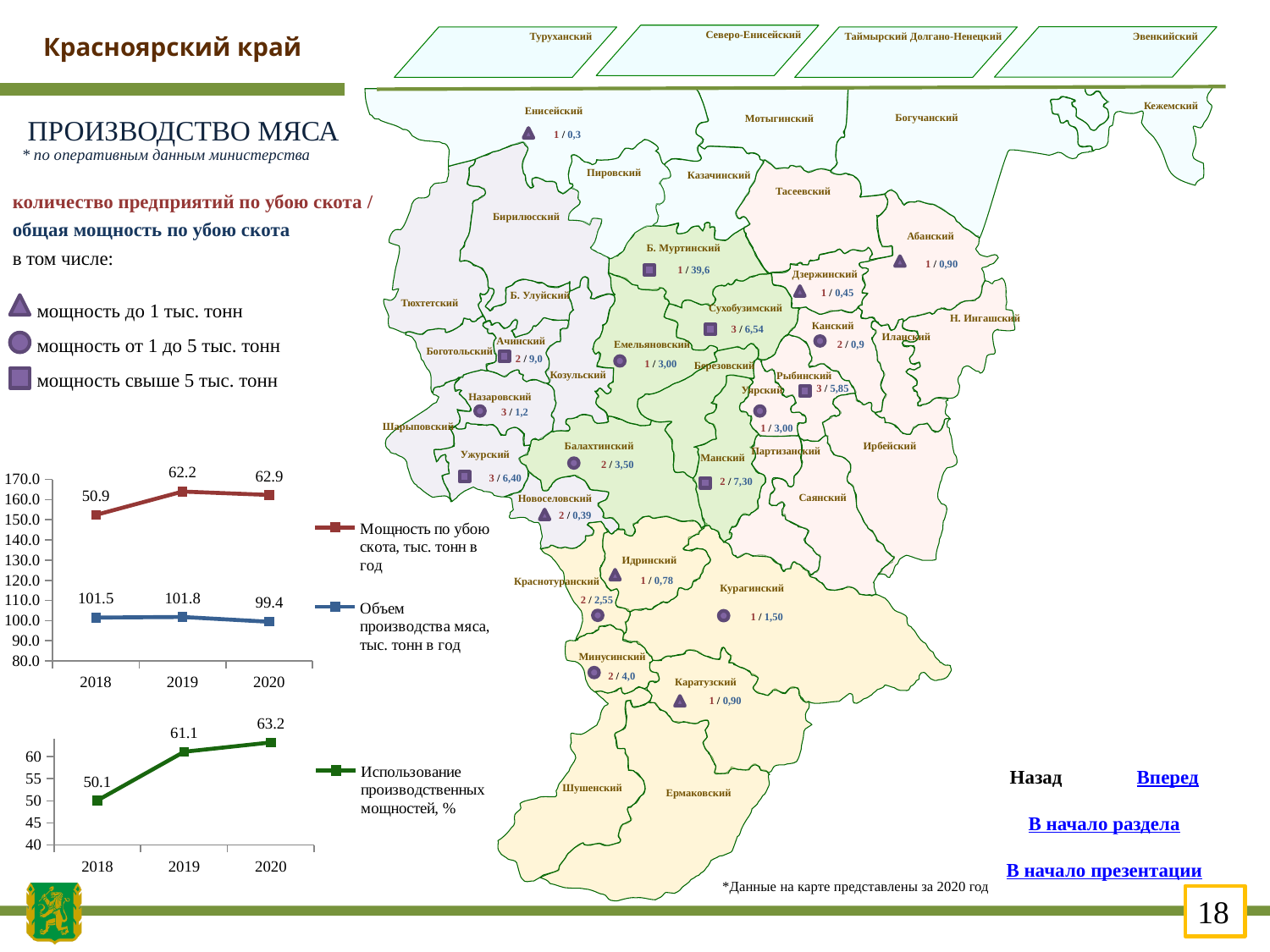
In the top chart, what is the value of 'Объем производства мяса, тыс. тонн в год' for 2020? 99.4 In the top chart, what is the value of 'Объем производства мяса, тыс. тонн в год' for 2018? 101.5 In the bottom chart, what is the difference between the 2020 and 2018 values of 'Использование производственных мощностей, %'? 13.1 In the top chart, what is the value of 'Мощность по убою скота, тыс. тонн в год' for 2019? 62.2 In the top chart, in which year is 'Объем производства мяса, тыс. тонн в год' highest? 2019 In the bottom chart, what is the value of 'Использование производственных мощностей, %' for 2018? 50.1 In the top chart, in which year is 'Мощность по убою скота, тыс. тонн в год' lowest? 2018 How many years are shown on the x axis of the bottom chart? 3 In the bottom chart, does 'Использование производственных мощностей, %' rise or fall from 2018 to 2020? rise What kind of chart is the bottom chart on the slide? line chart In the top chart, what is the difference between the 'Объем производства мяса' values for 2019 and 2020? 2.4 How many series does the legend of the top chart list? 2